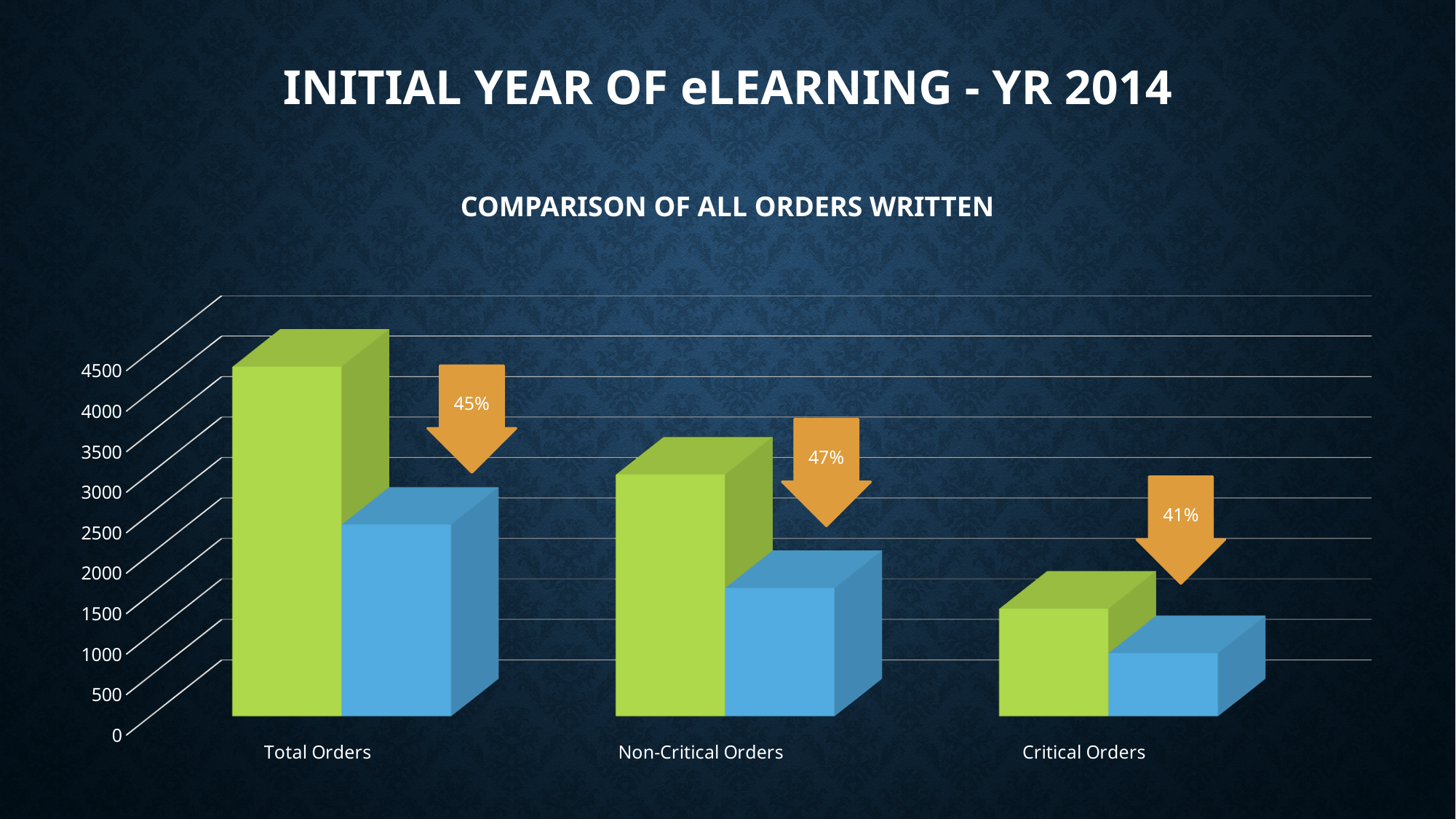
Which category has the shortest blue bar? Critical Orders Is the green bar for Total Orders greater or less than 4000? greater Do the bar heights rise or fall moving from Total Orders to Critical Orders along the x axis? Fall How many categories are shown on the x axis of the chart? 3 For Non-Critical Orders, which bar is taller, the green one or the blue one? Green Which category has the tallest green bar? Total Orders What kind of chart is shown on the slide? Bar chart What is the title of the chart? Comparison of All Orders Written Is the green bar for Critical Orders greater or less than 2000? less What percentage is shown in the arrow above the Non-Critical Orders bars? 47% Is the blue bar for Total Orders greater or less than 2000? greater